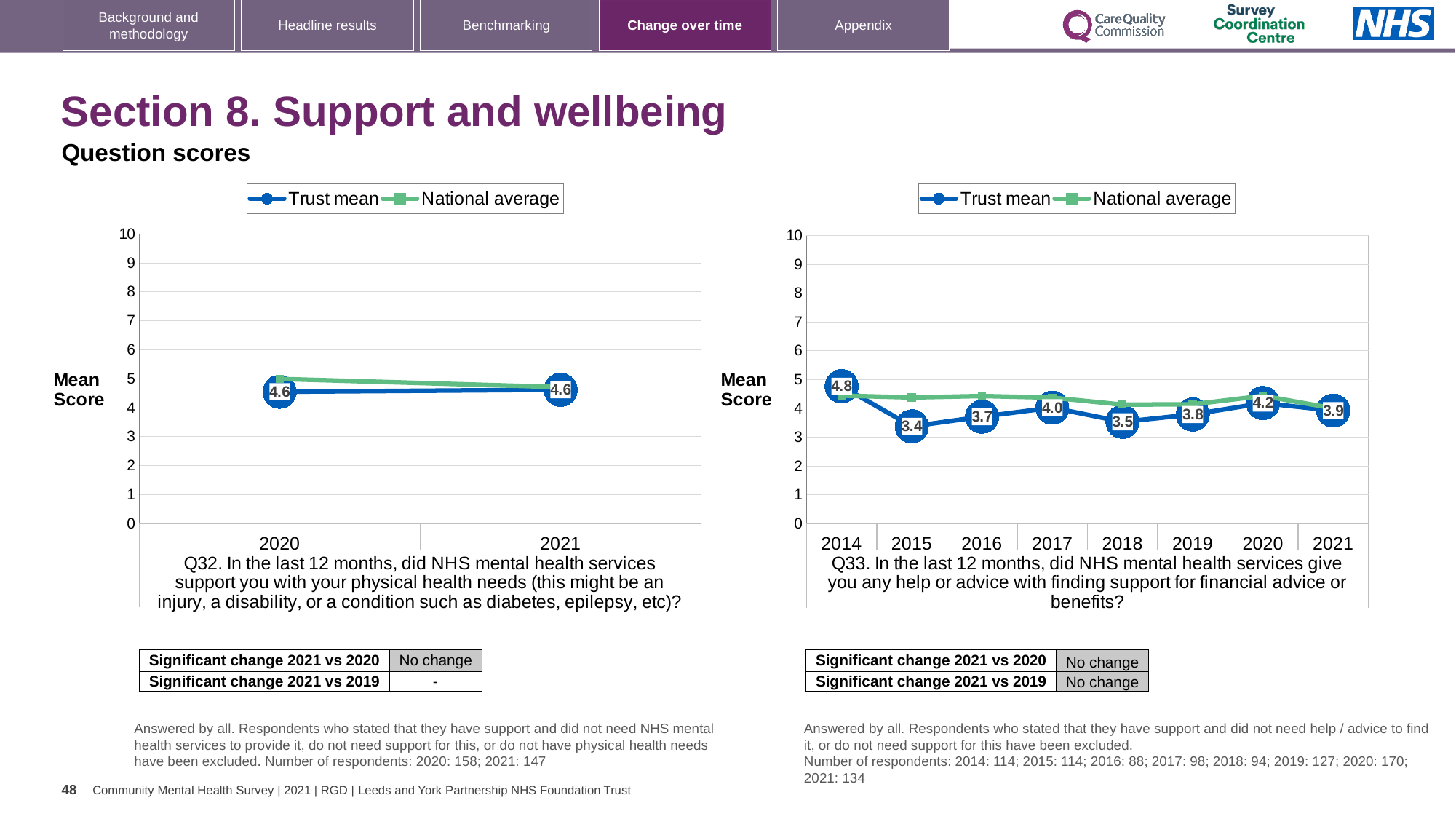
In the Q33 chart on the right, what is the Trust mean for 2015? 3.4 In the Q33 chart on the right, which year has the highest Trust mean? 2014 In the Q33 chart on the right, which year has the lowest Trust mean? 2015 What type of chart is the Q33 chart on the right? Line chart In the Q33 chart on the right, is the Trust mean higher in 2017 or in 2018? 2017 In the Q33 chart on the right, what is the difference between the Trust mean in 2014 and in 2015? 1.4 In the Q33 chart on the right, what is the Trust mean for 2020? 4.2 In the Q32 chart on the left, what is the Trust mean for 2020? 4.6 How many series does the legend of the Q32 chart on the left list? 2 In the Q32 chart on the left, what is the Trust mean for 2021? 4.6 How many years are plotted on the x axis of the Q33 chart on the right? 8 In the Q33 chart on the right, is the National average for 2014 greater or less than 5? less